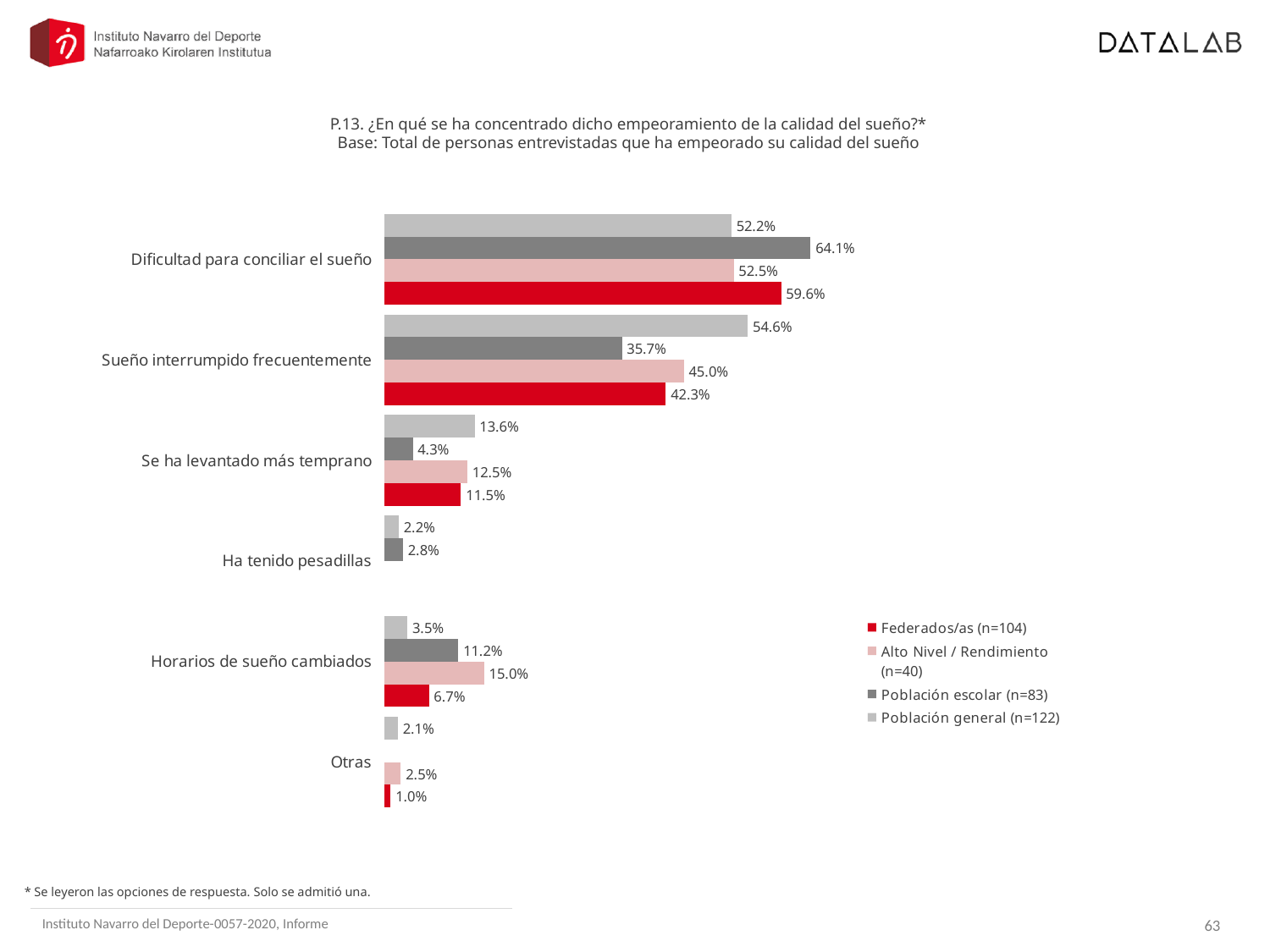
What is the difference between Población escolar (n=83) and Población general (n=122) for 'Dificultad para conciliar el sueño'? 11.9% Which series is shown in red in the legend? Federados/as (n=104) What is the value for Federados/as (n=104) for 'Dificultad para conciliar el sueño'? 59.6% Which category has the highest value for Población escolar (n=83)? Dificultad para conciliar el sueño What kind of chart is shown on the slide? Bar chart What is the value for Alto Nivel / Rendimiento (n=40) for 'Horarios de sueño cambiados'? 15.0% For 'Sueño interrumpido frecuentemente', which is larger: Alto Nivel / Rendimiento (n=40) or Federados/as (n=104)? Alto Nivel / Rendimiento (n=40) What is the value for Población escolar (n=83) for 'Sueño interrumpido frecuentemente'? 35.7% What is the value for Población general (n=122) for 'Se ha levantado más temprano'? 13.6% How many series does the legend list? 4 How many categories are shown on the chart? 6 Which category has the lowest value for Federados/as (n=104)? Otras